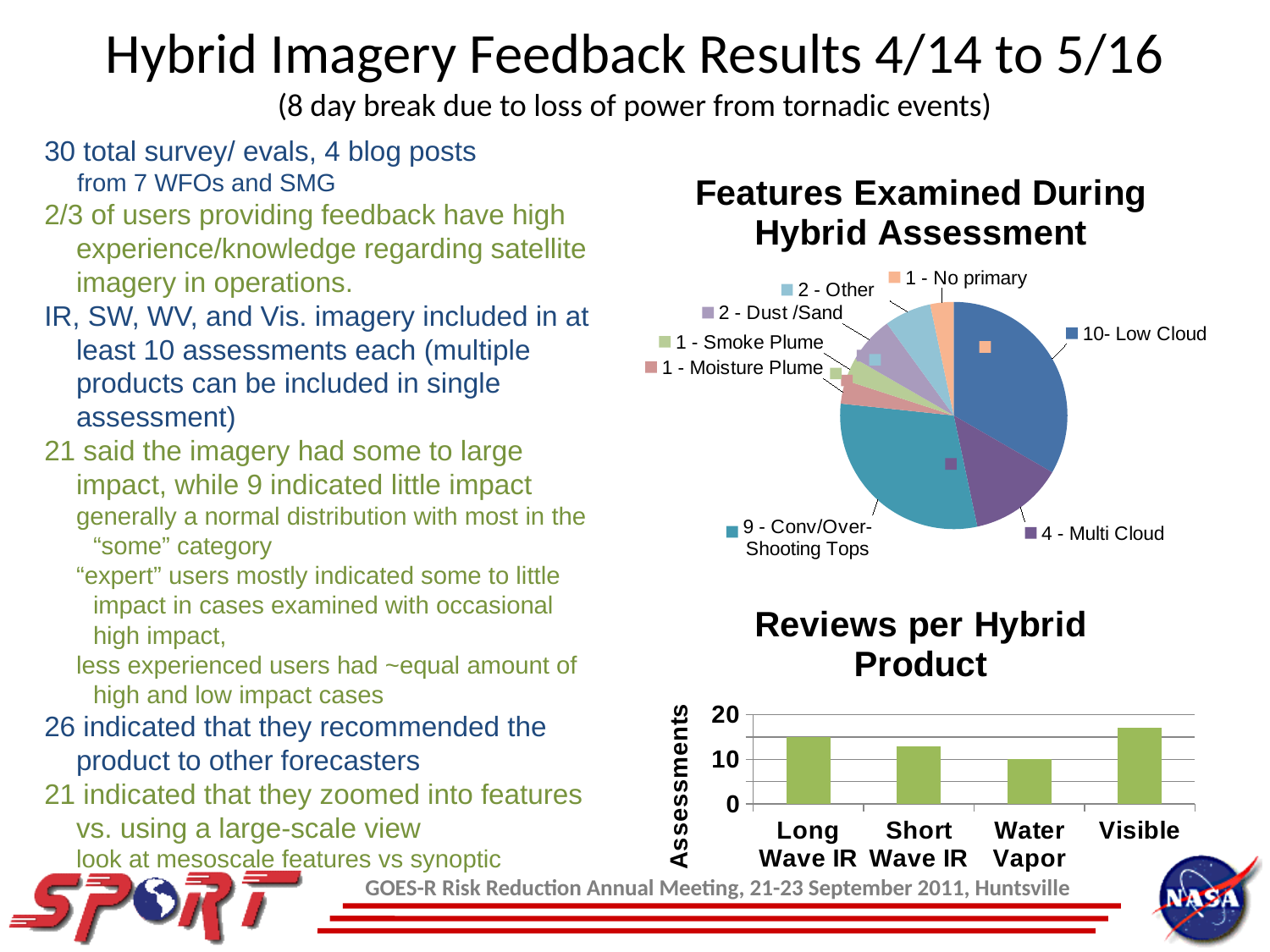
In the 'Features Examined During Hybrid Assessment' chart, how many assessments examined Conv/Over-Shooting Tops? 9 In the 'Reviews per Hybrid Product' chart, which product has the fewest assessments? Water Vapor What kind of chart is 'Reviews per Hybrid Product'? Bar chart In the 'Reviews per Hybrid Product' chart, is the value for Visible greater or less than 20? less In the 'Reviews per Hybrid Product' chart, how many assessments are shown for Water Vapor? 10 In the 'Features Examined During Hybrid Assessment' chart, how many assessments examined Low Cloud? 10 In the 'Features Examined During Hybrid Assessment' chart, which is larger, Dust/Sand or Multi Cloud? Multi Cloud In the 'Features Examined During Hybrid Assessment' chart, how many slices does the pie have? 8 In the 'Reviews per Hybrid Product' chart, which product has the most assessments? Visible In the 'Features Examined During Hybrid Assessment' chart, which feature has the largest slice? Low Cloud What kind of chart is 'Features Examined During Hybrid Assessment'? Pie chart In the 'Features Examined During Hybrid Assessment' chart, what is the difference between the Low Cloud count and the Multi Cloud count? 6